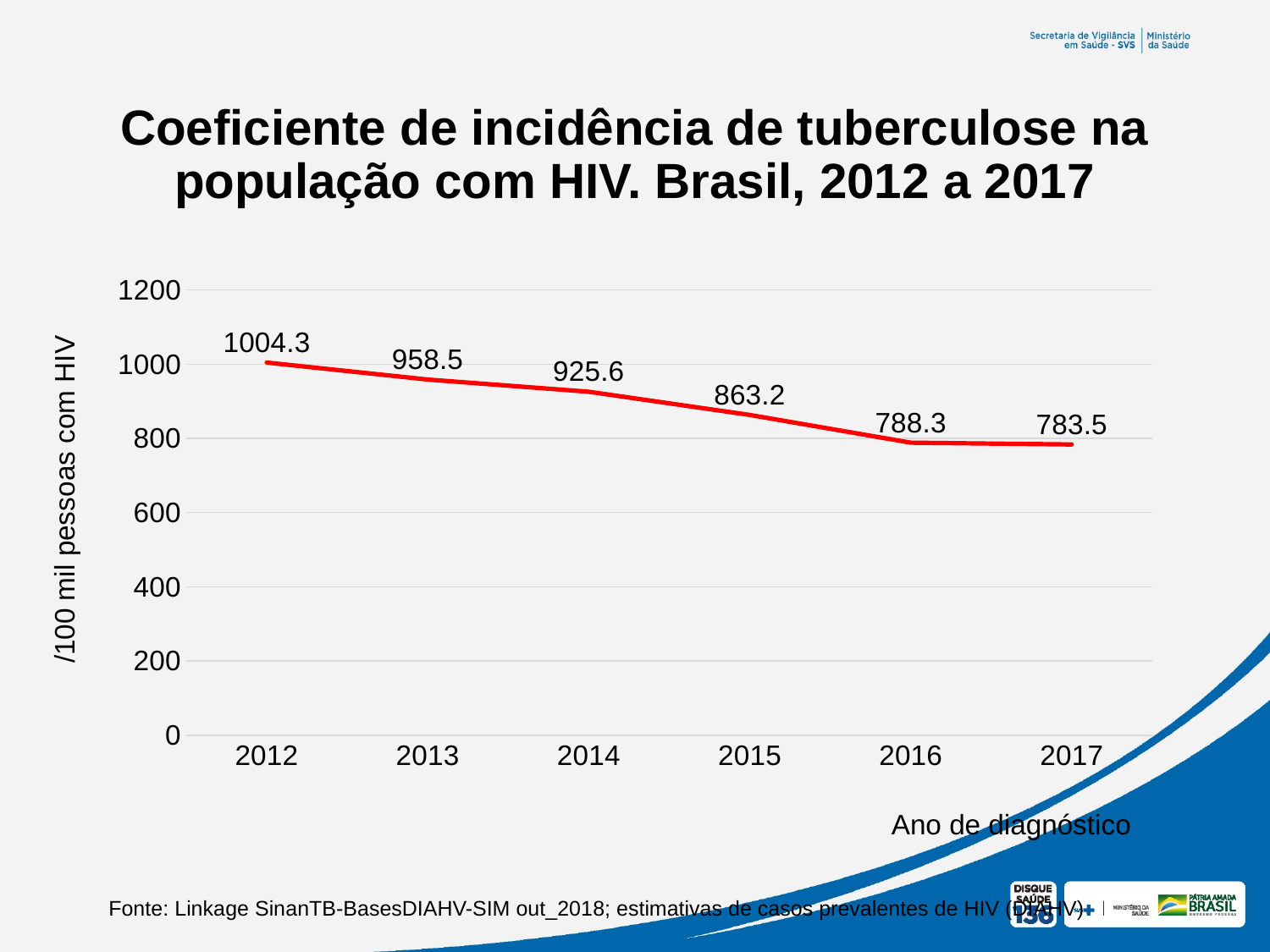
Which year has the lowest incidence coefficient? 2017 Which year has a larger value, 2013 or 2016? 2013 What is the difference between the values for 2012 and 2017? 220.8 Do the values rise or fall from 2012 to 2017? fall What is the value plotted for 2015? 863.2 What is the tuberculosis incidence coefficient for 2012? 1004.3 What kind of chart is shown on the slide? line chart What is the value plotted for 2017? 783.5 Which year has the highest incidence coefficient? 2012 What is the difference between the values for 2014 and 2015? 62.4 Is the value for 2014 greater or less than 1000? less How many years are plotted on the chart? 6